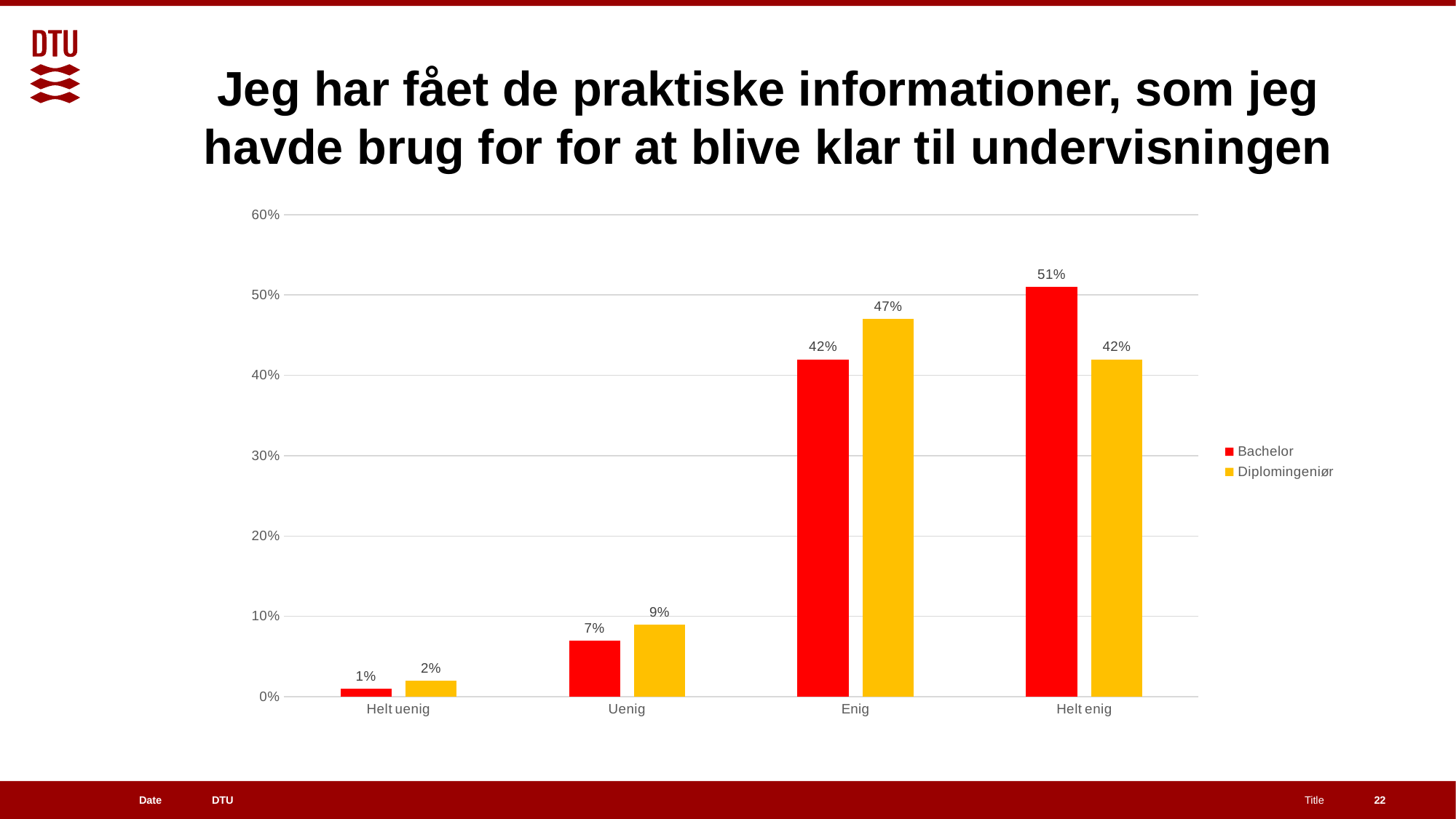
What is the value for Bachelor in the Helt enig category? 51% Which category has the lowest value for Diplomingeniør? Helt uenig Which category has the highest value for Bachelor? Helt enig What is the value for Diplomingeniør in the Enig category? 47% What is the value for Bachelor in the Uenig category? 7% How many categories are shown on the x axis? 4 In the Enig category, which series has the larger value, Bachelor or Diplomingeniør? Diplomingeniør Which colour represents the Diplomingeniør series? Yellow What is the value for Diplomingeniør in the Helt uenig category? 2% What is the difference between the Bachelor and Diplomingeniør values in the Helt enig category? 9% How many series does the legend list? 2 What kind of chart is shown on the slide? Bar chart